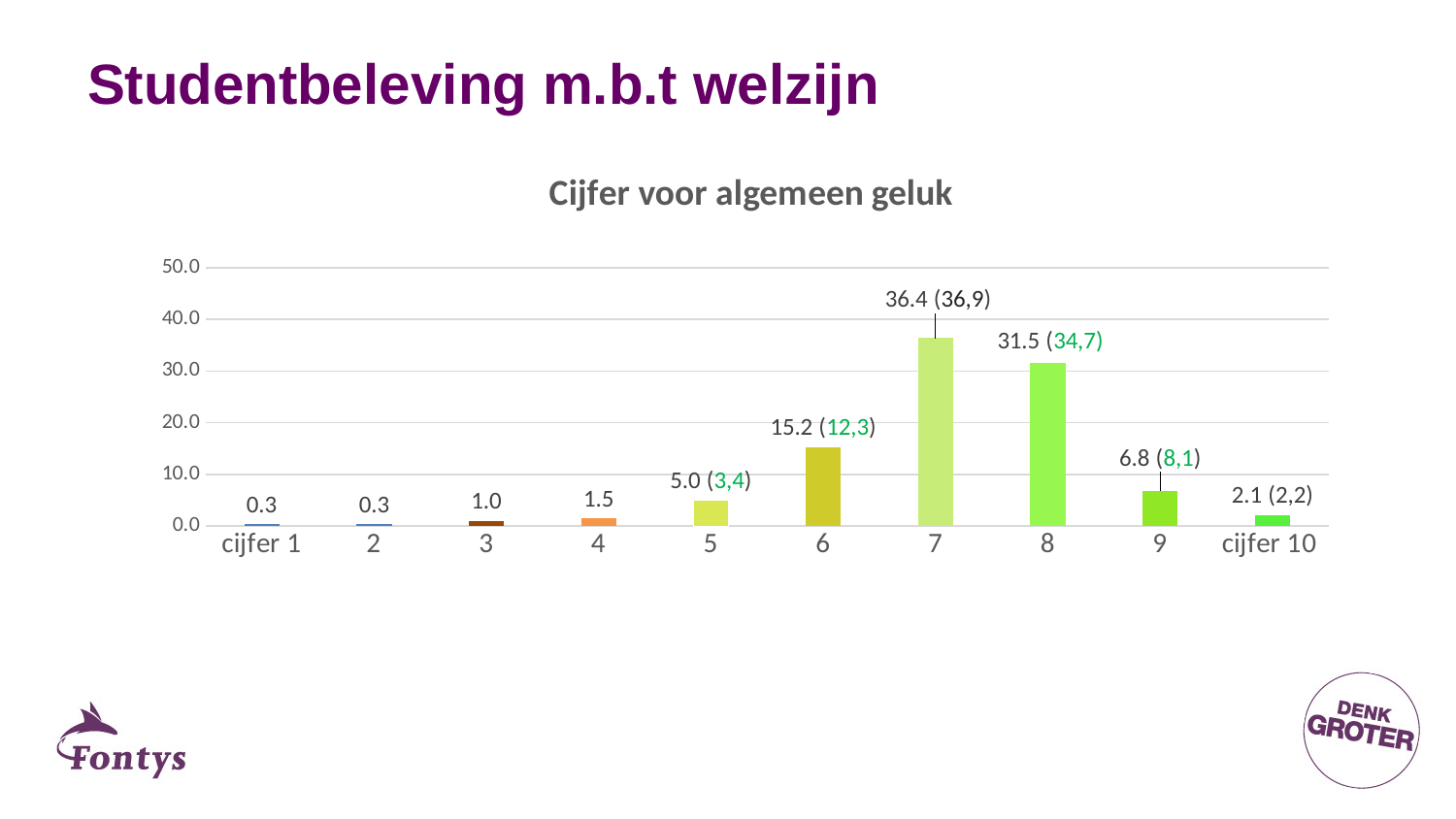
What is the difference between the values for category 7 and category 8? 4.9 What kind of chart is shown on the slide? bar chart How many categories are shown on the x axis? 10 What is the difference between the values for category 6 and category 5? 10.2 Which category has the highest value? 7 Is the value for category 8 greater or less than 30.0? greater What is the value shown for 'cijfer 10'? 2.1 What is the value shown for category 8? 31.5 What is the value shown for category 4? 1.5 Which has a larger value, category 6 or category 9? 6 What is the title of the chart? Cijfer voor algemeen geluk What is the value shown for category 7 in the chart? 36.4